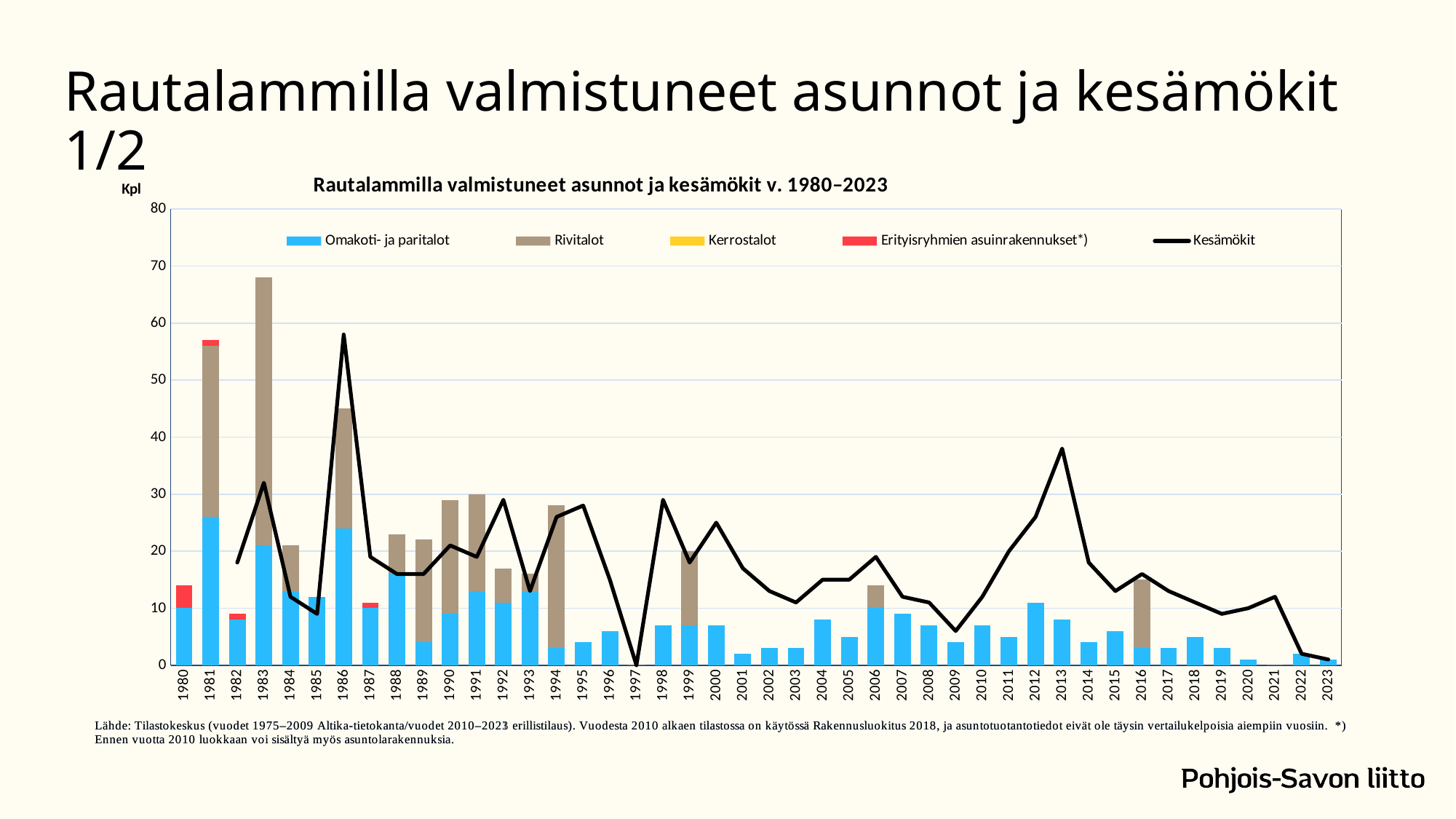
Is the Kesämökit value for 2013 greater or less than 30? greater Is the total stacked bar for 1983 greater or less than 60? greater How many series does the legend list? 5 How is the Kesämökit series drawn on the chart? As a line In which year does the Kesämökit line reach its highest point? 1986 How many years are shown on the x axis? 44 Which year has the taller stacked bar, 1983 or 1986? 1983 What is the label on the y axis? Kpl Does the Kesämökit line rise or fall overall from 2013 to 2023? Falls In which year does the Kesämökit line reach its lowest point? 1997 Is the bar for 2020 greater or less than 5? less In which year is the stacked bar for completed dwellings the tallest? 1983